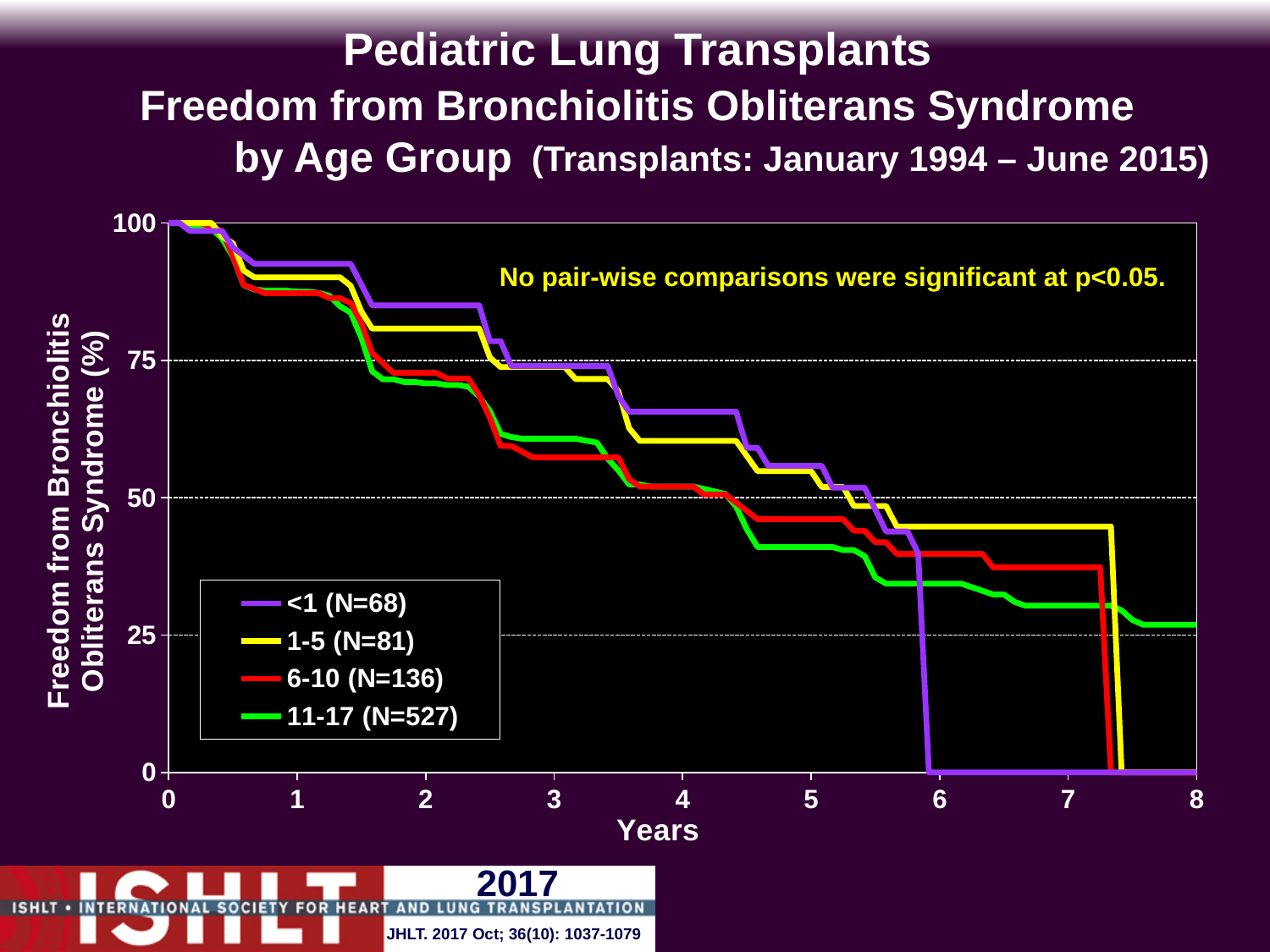
Is the value for the <1 age group at 2 years greater or less than 75%? greater Do the values for the 11-17 age group rise or fall as years increase? fall At 6 years, which is higher: the 1-5 age group or the 11-17 age group? 1-5 How many series does the legend list? 4 What kind of chart is shown on the slide? line chart What is the N for the <1 age group shown in the legend? 68 At 2 years, which is higher: the <1 age group or the 11-17 age group? <1 Which age group's curve extends to 8 years on the x axis? 11-17 Which age group has the largest number of patients (N) according to the legend? 11-17 (N=527) Is the value for the 1-5 age group at 6 years greater or less than 50%? less Is the value for the 11-17 age group at 2 years greater or less than 75%? less